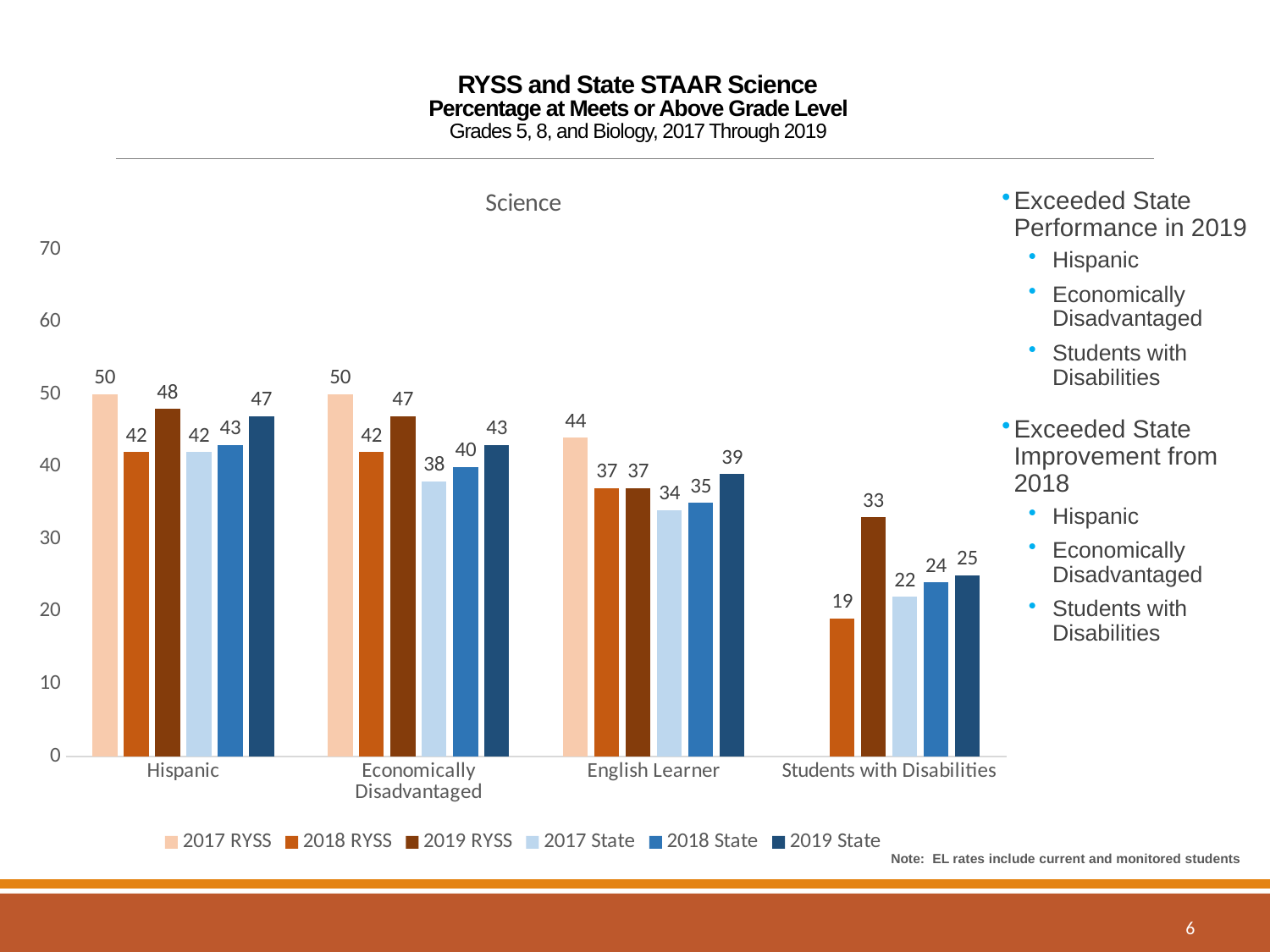
What is the 2019 RYSS value for Hispanic? 48 How many categories are shown on the x axis? 4 Is the 2017 RYSS value for Hispanic greater or less than 40? greater For Students with Disabilities, how much higher is the 2019 RYSS value than the 2018 RYSS value? 14 What kind of chart is shown on the slide? bar chart What is the 2018 State value for English Learner? 35 Which category has the highest 2019 State value? Hispanic What is the 2019 RYSS value for Students with Disabilities? 33 How many series does the legend list? 6 For English Learner, which is larger: the 2019 RYSS value or the 2019 State value? 2019 State Which category has the lowest 2018 RYSS value? Students with Disabilities For Economically Disadvantaged, what is the difference between the 2019 RYSS value and the 2019 State value? 4